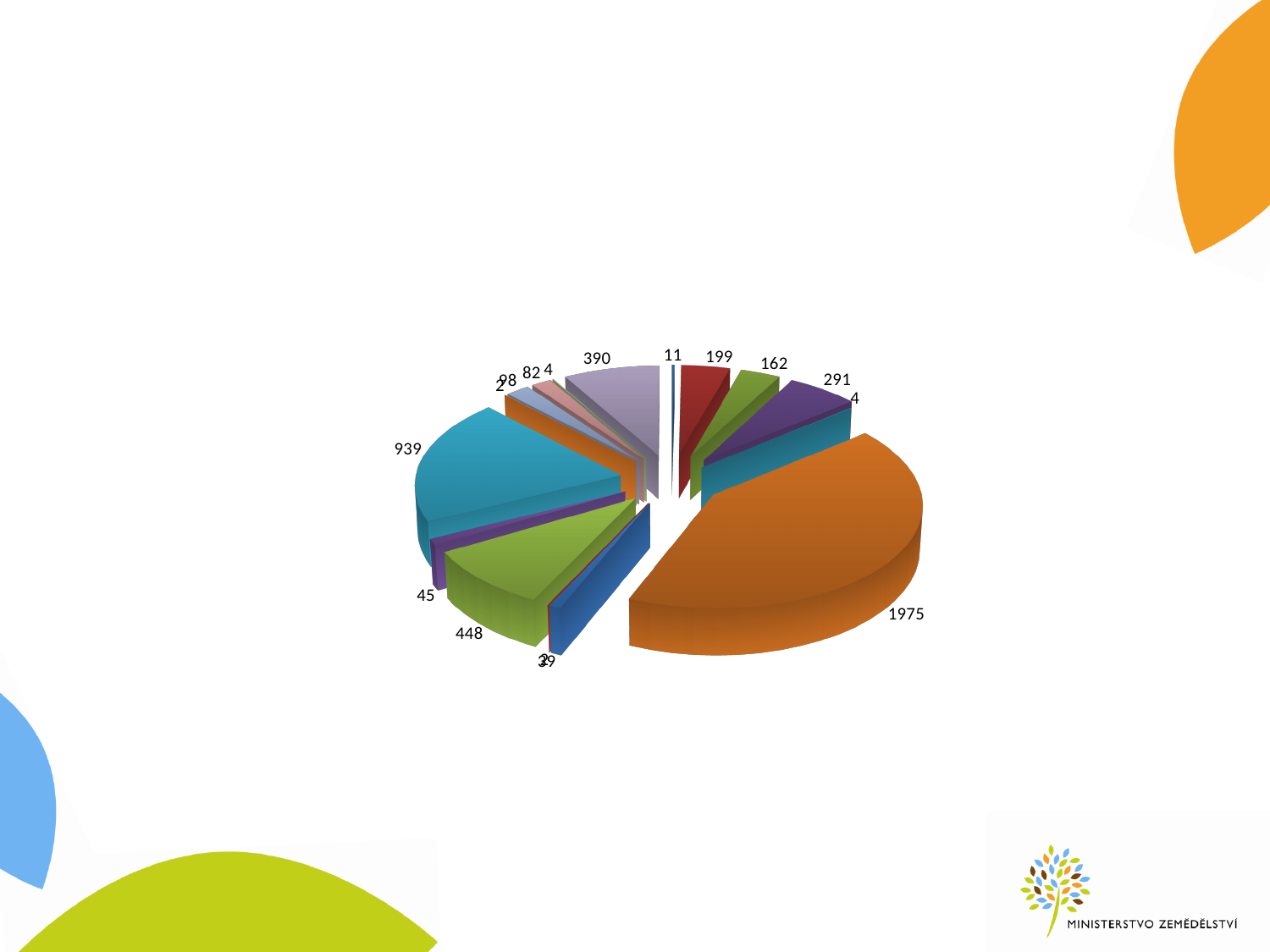
What is the difference between the largest slice (1975) and the teal slice (939)? 1036 What is the value of the light purple slice at the top of the pie chart? 390 What is the value of the green slice at the bottom left of the pie chart? 448 What is the difference between the slices labelled 448 and 390? 58 Does the pie chart have a legend? No Which is larger: the green slice labelled 448 or the light purple slice labelled 390? 448 What is the value of the large teal slice on the left side of the pie chart? 939 What colour is the largest slice of the pie chart? orange What kind of chart is shown on the slide? pie chart What is the value of the dark red slice near the top of the pie chart? 199 What is the value of the dark purple slice at the top right of the pie chart? 291 What is the value of the largest slice of the pie chart? 1975